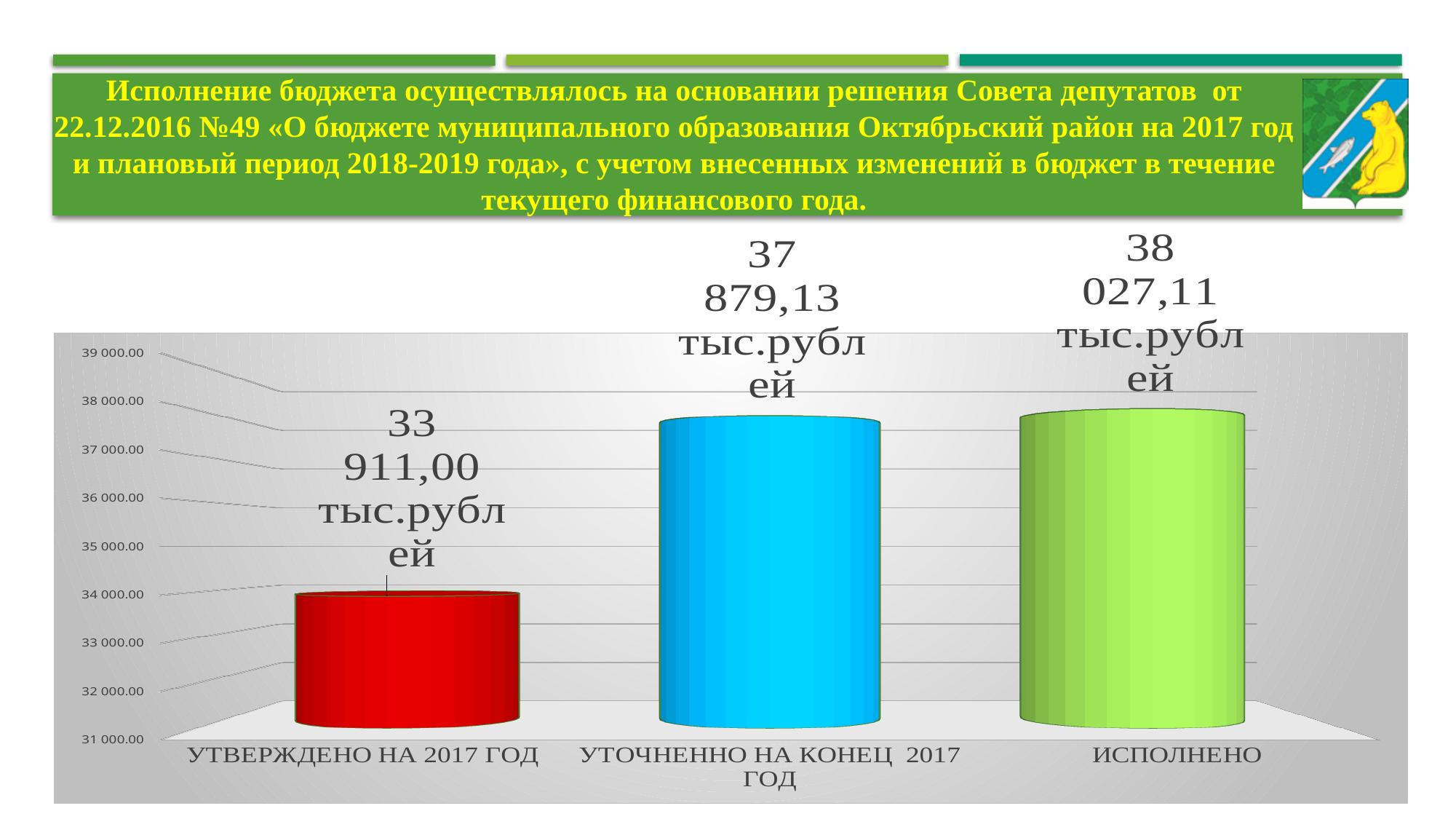
What value is shown for ИСПОЛНЕНО? 38 027,11 тыс.рублей How many categories are shown in the chart? 3 Do the values rise or fall from left to right across the categories? rise Which category has the highest value? ИСПОЛНЕНО Is the value for УТВЕРЖДЕНО НА 2017 ГОД greater or less than 35 000.00? less Which category has the lowest value? УТВЕРЖДЕНО НА 2017 ГОД What kind of chart is shown on the slide? bar chart What is the difference between the values for ИСПОЛНЕНО and УТОЧНЕННО НА КОНЕЦ 2017 ГОД? 147,98 тыс.рублей Which is larger: the value for УТОЧНЕННО НА КОНЕЦ 2017 ГОД or the value for УТВЕРЖДЕНО НА 2017 ГОД? УТОЧНЕННО НА КОНЕЦ 2017 ГОД What value is shown for УТОЧНЕННО НА КОНЕЦ 2017 ГОД? 37 879,13 тыс.рублей What is the difference between the values for ИСПОЛНЕНО and УТВЕРЖДЕНО НА 2017 ГОД? 4 116,11 тыс.рублей What value is shown for УТВЕРЖДЕНО НА 2017 ГОД? 33 911,00 тыс.рублей